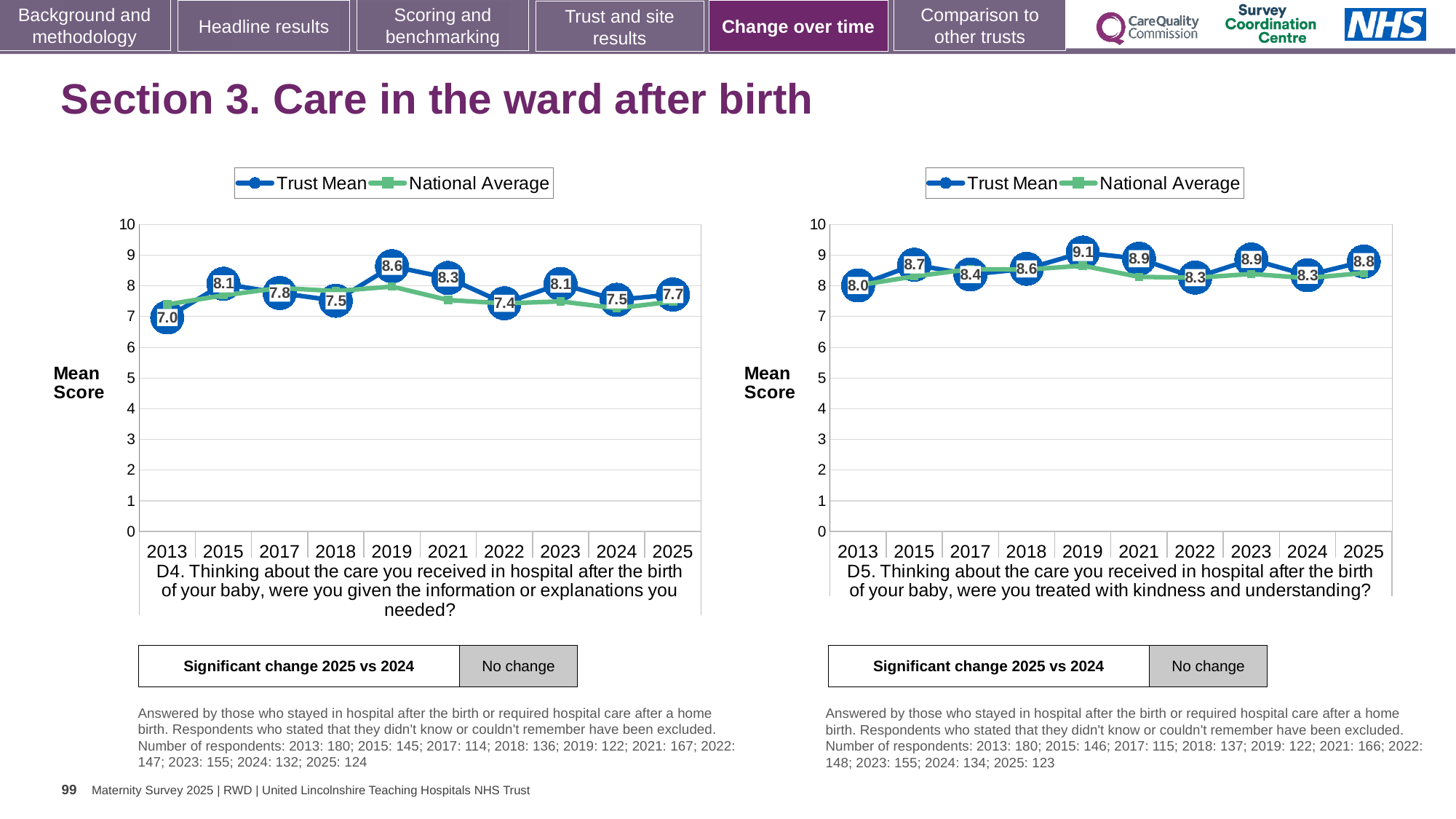
In the left chart (D4), what is the difference between the Trust Mean scores for 2019 and 2022? 1.2 In the right chart (D5), what is the Trust Mean score for 2013? 8.0 What kind of chart is the right chart (D5)? Line chart How many series does the legend of the left chart (D4) list? 2 In the right chart (D5), which year has the highest Trust Mean score? 2019 In the left chart (D4), which year has the lowest Trust Mean score? 2013 In the right chart (D5), is the Trust Mean score higher in 2025 or in 2024? 2025 In the left chart (D4), what is the Trust Mean score for 2019? 8.6 How many years are shown on the x axis of the right chart (D5)? 10 In the left chart (D4), is the National Average value for 2013 greater or less than 7? greater What does the 'Significant change 2025 vs 2024' box below the left chart (D4) say? No change In the right chart (D5), what is the difference between the Trust Mean scores for 2019 and 2013? 1.1